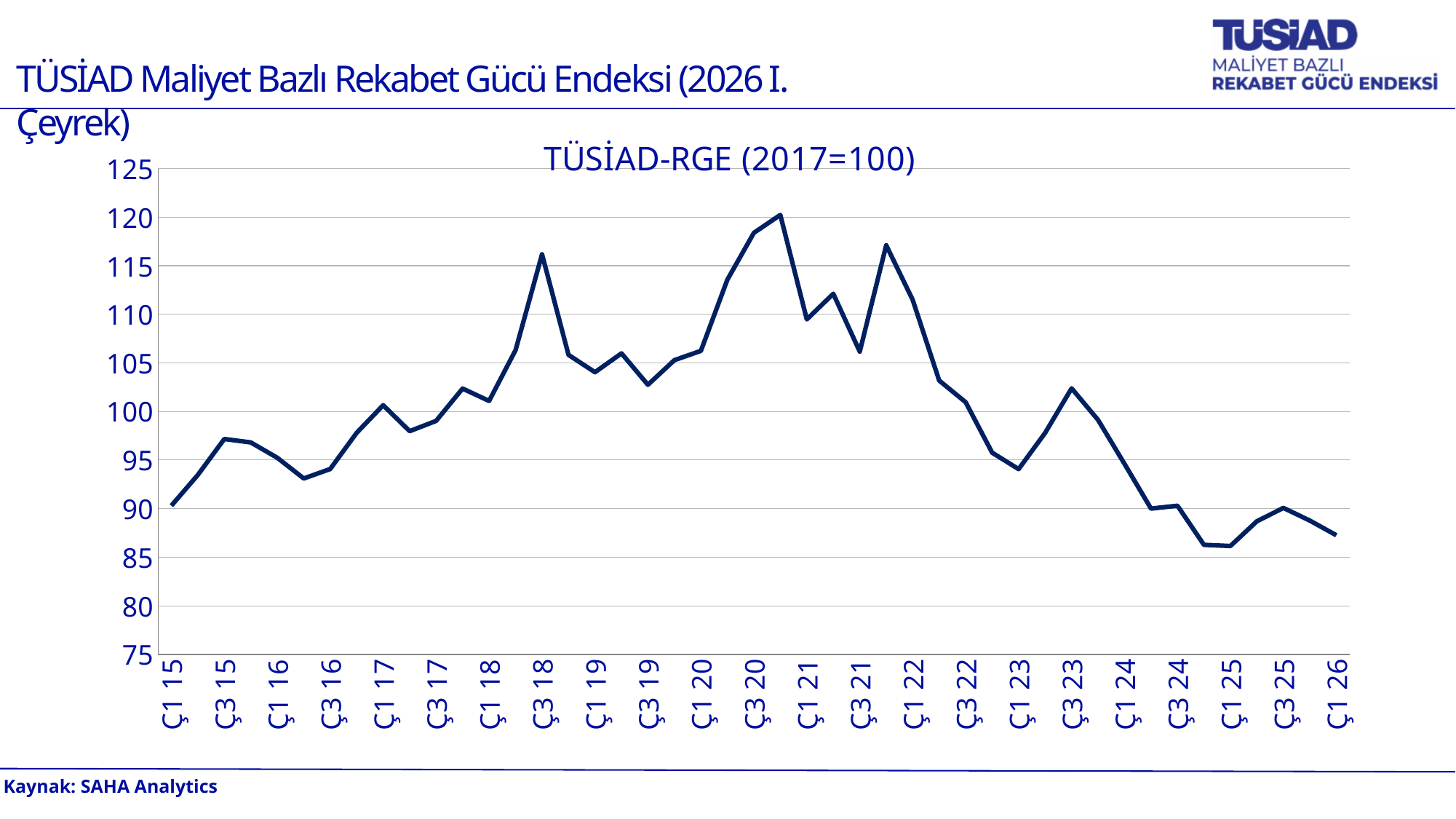
Is the value for Ç1 26 greater or less than 90? less Is the value for Ç3 20 greater or less than 115? greater Which is larger, the value for Ç3 20 or the value for Ç1 26? Ç3 20 What is the title of the chart? TÜSİAD-RGE (2017=100) Is the value for Ç1 22 greater or less than 110? greater Does the index generally rise or fall between Ç1 22 and Ç1 26? fall Which is larger, the value for Ç1 15 or the value for Ç3 18? Ç3 18 Which year is the base year (=100) for the index shown in the chart? 2017 What kind of chart is shown on the slide? line chart